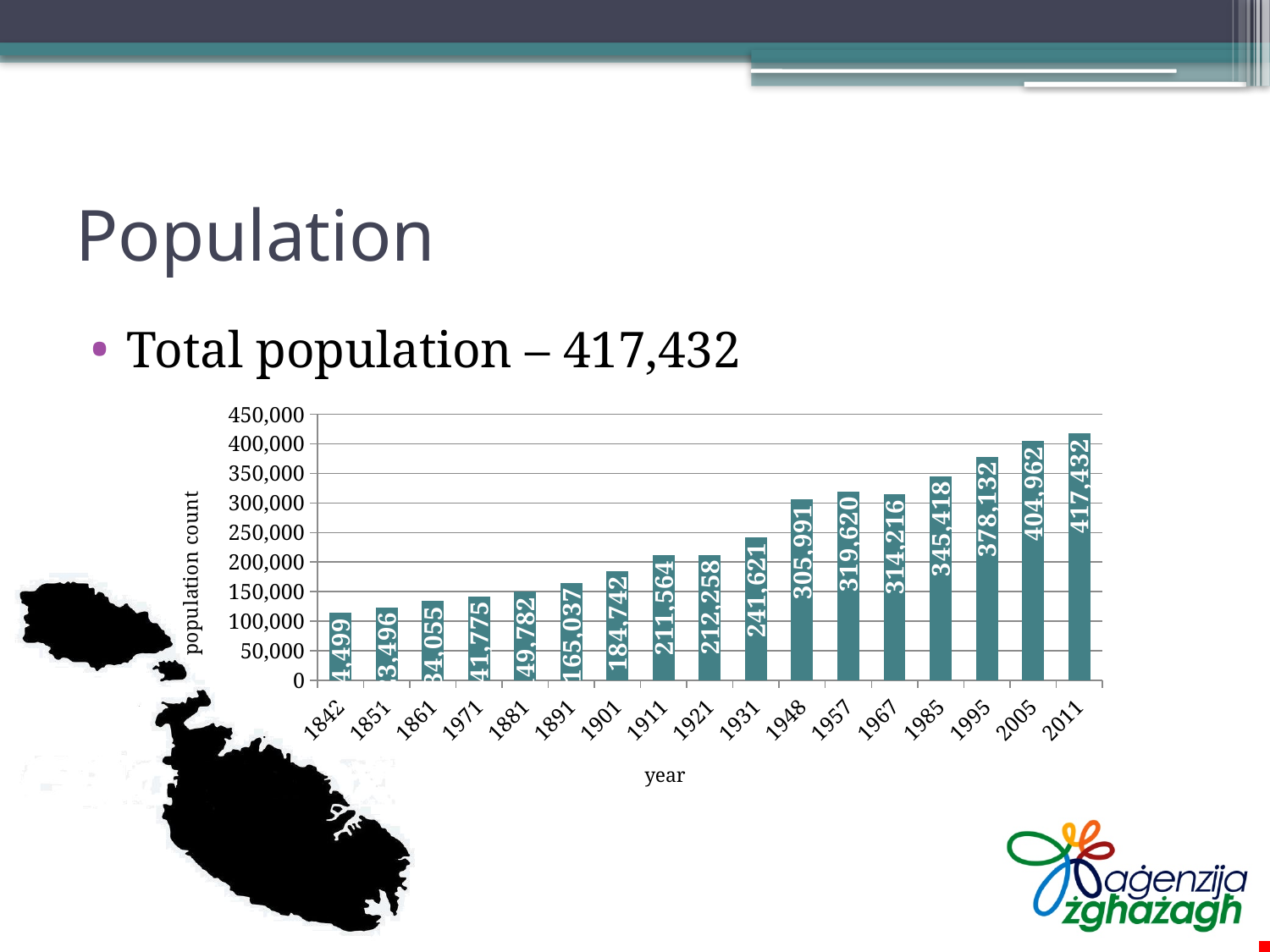
Which year has the larger population count, 1957 or 1967? 1957 What is the population count for 1948? 305,991 What is the population count for 2011? 417,432 What is the population count for 1901? 184,742 What kind of chart is shown on the slide? bar chart What is the difference between the population counts for 2011 and 2005? 12,470 Which year has the lowest population count? 1842 Is the population count for 1842 greater or less than 150,000? less What is the label of the vertical axis of the chart? population count What is the population count for 1985? 345,418 Which year has the highest population count? 2011 How many years are shown on the x axis of the chart? 17